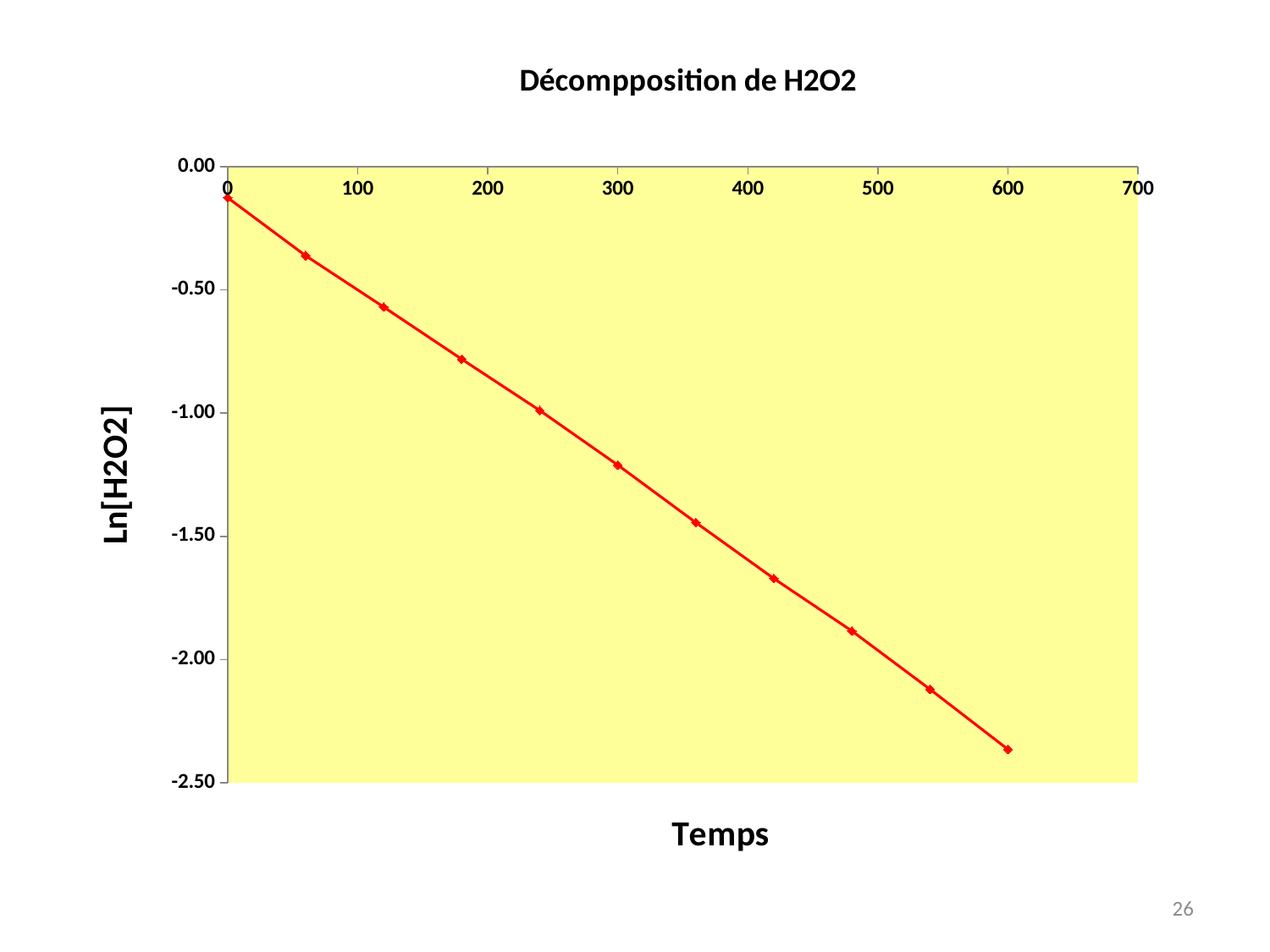
What is the title of the chart? Décompposition de H2O2 At which Temps value is Ln[H2O2] highest? 0 Is the value of Ln[H2O2] at Temps 480 greater or less than -2.00? greater Is the value of Ln[H2O2] at Temps 600 greater or less than -2.00? less What kind of chart is shown on the slide? line chart Is the value of Ln[H2O2] at Temps 0 greater or less than -0.50? greater Do the values rise or fall as Temps increases along the x axis? fall What is the label of the y axis? Ln[H2O2] Which has the larger Ln[H2O2] value, Temps 60 or Temps 540? Temps 60 How many data points are plotted on the line? 11 At which Temps value is Ln[H2O2] lowest? 600